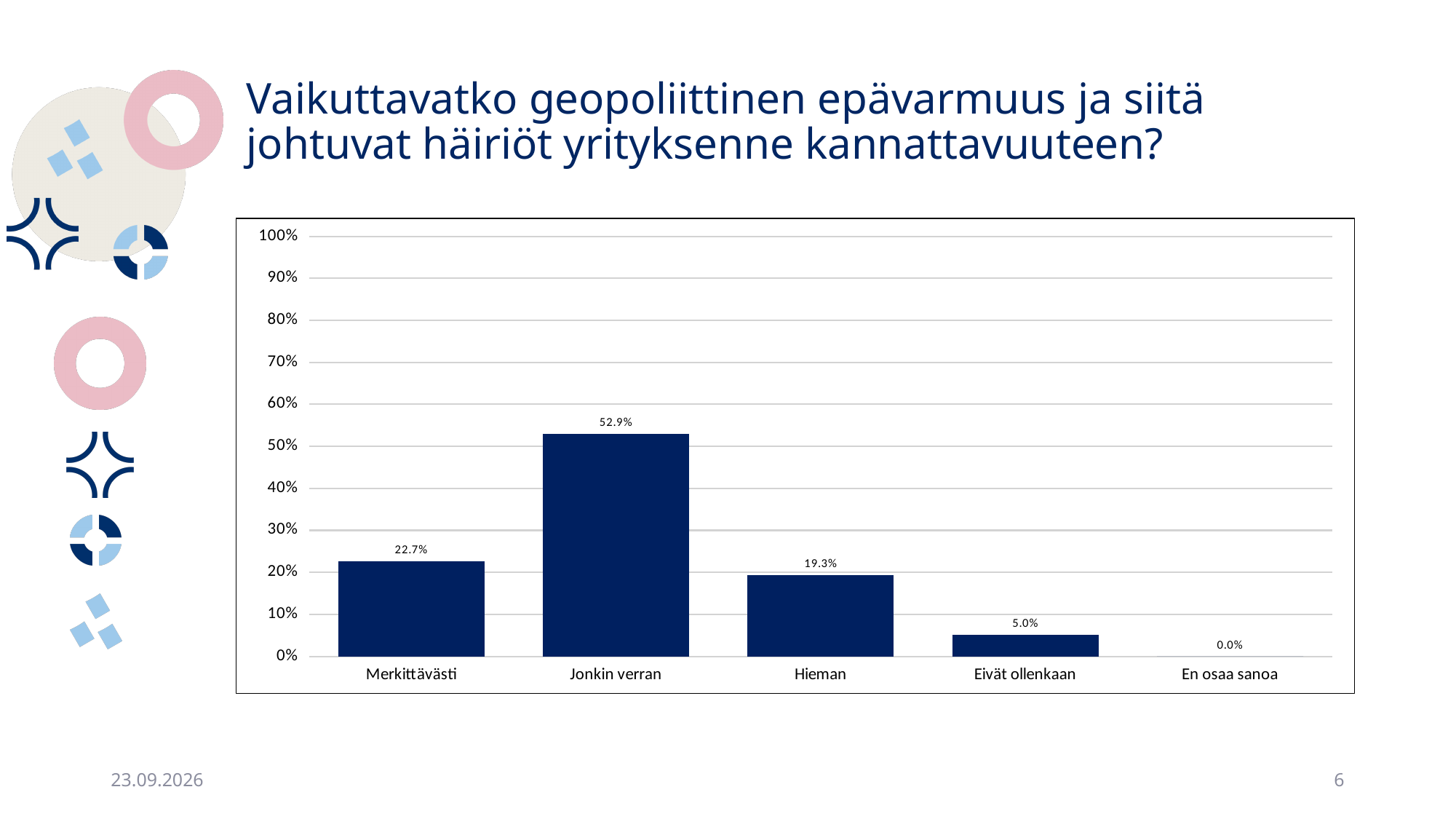
What is the value for Eivät ollenkaan? 5.0% What is the value for Merkittävästi? 22.7% How many categories are shown on the x axis? 5 Which category has the highest value? Jonkin verran What kind of chart is shown on the slide? Bar chart What is the difference between the values for Jonkin verran and Merkittävästi? 30.2% Which is larger, the value for Merkittävästi or the value for Hieman? Merkittävästi Which category has the lowest value? En osaa sanoa What is the value for Jonkin verran? 52.9% Is the value for Jonkin verran greater or less than 50%? greater What is the value for Hieman? 19.3% What is the value for En osaa sanoa? 0.0%